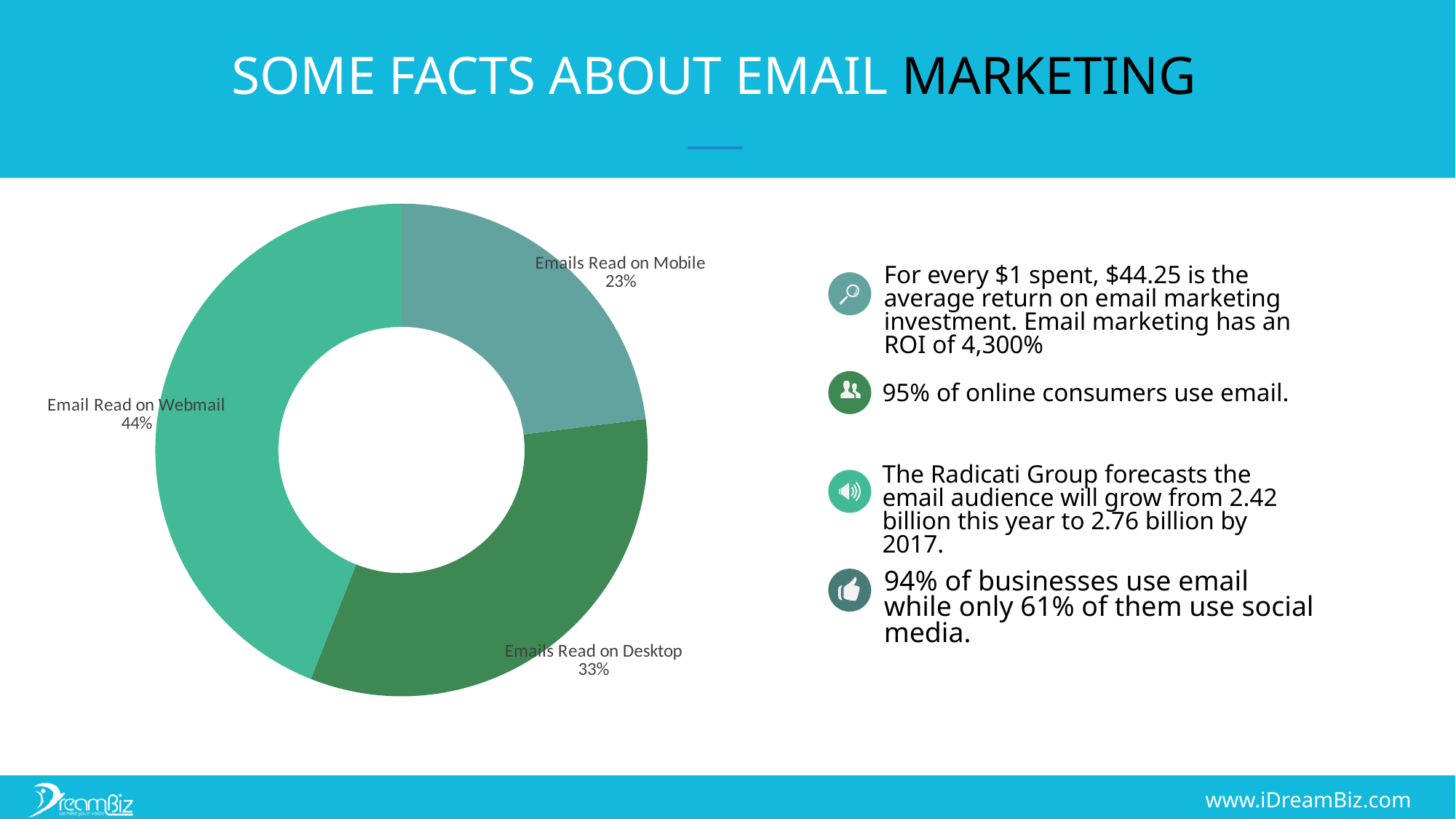
What is the difference in percentage points between Emails Read on Webmail and Emails Read on Mobile? 21 Which category has the largest share in the chart? Email Read on Webmail What kind of chart is shown on the slide? Doughnut chart Which category has the smallest share in the chart? Emails Read on Mobile What is the combined share of Emails Read on Desktop and Emails Read on Mobile? 56% What percentage of emails are read on Mobile according to the chart? 23% What is the difference in percentage points between Emails Read on Desktop and Emails Read on Mobile? 10 What is the title of the slide containing the chart? SOME FACTS ABOUT EMAIL MARKETING Which is larger: the share for Emails Read on Desktop or Emails Read on Mobile? Emails Read on Desktop What percentage of emails are read on Desktop according to the chart? 33% What percentage of emails are read on Webmail according to the chart? 44% How many categories are shown in the chart? 3